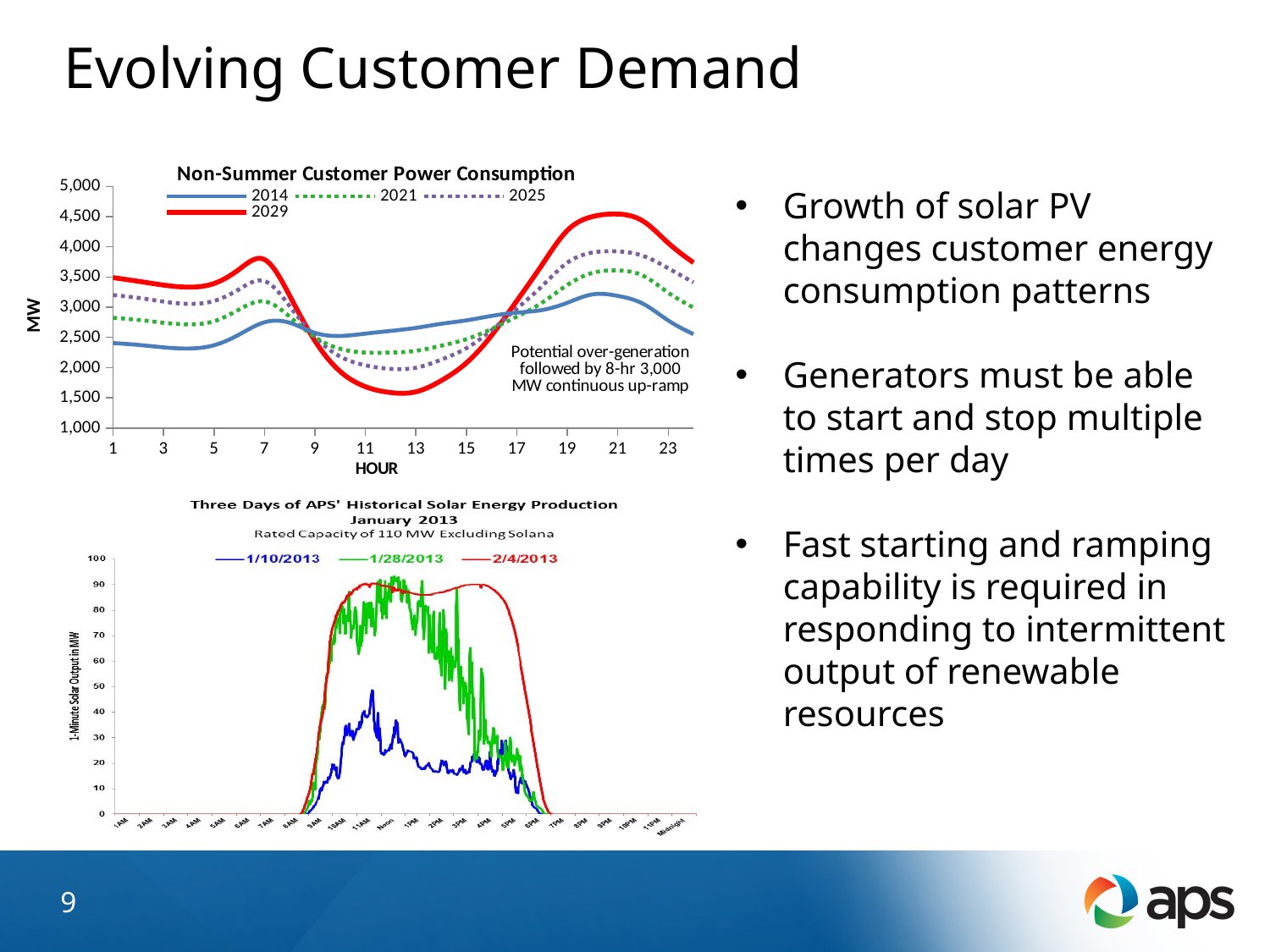
In the 'Non-Summer Customer Power Consumption' chart, is the value for 2014 at hour 1 greater or less than 3,000? less In the 'Non-Summer Customer Power Consumption' chart, is the value for 2029 at hour 21 greater or less than 4,000? greater How many series does the legend of the 'Non-Summer Customer Power Consumption' chart list? 4 In the 'Non-Summer Customer Power Consumption' chart, which series is larger at hour 13, 2014 or 2029? 2014 In the 'Non-Summer Customer Power Consumption' chart, is the value for 2029 at hour 13 greater or less than 2,000? less What is the y-axis label of the 'Non-Summer Customer Power Consumption' chart? MW In the 'Non-Summer Customer Power Consumption' chart, which series reaches the highest peak? 2029 In the 'Non-Summer Customer Power Consumption' chart, which series drops to the lowest value around midday? 2029 In the 'Three Days of APS' Historical Solar Energy Production' chart, which day has the lowest peak output? 1/10/2013 What kind of chart is the 'Non-Summer Customer Power Consumption' chart? line chart How many series does the legend of the 'Three Days of APS' Historical Solar Energy Production' chart list? 3